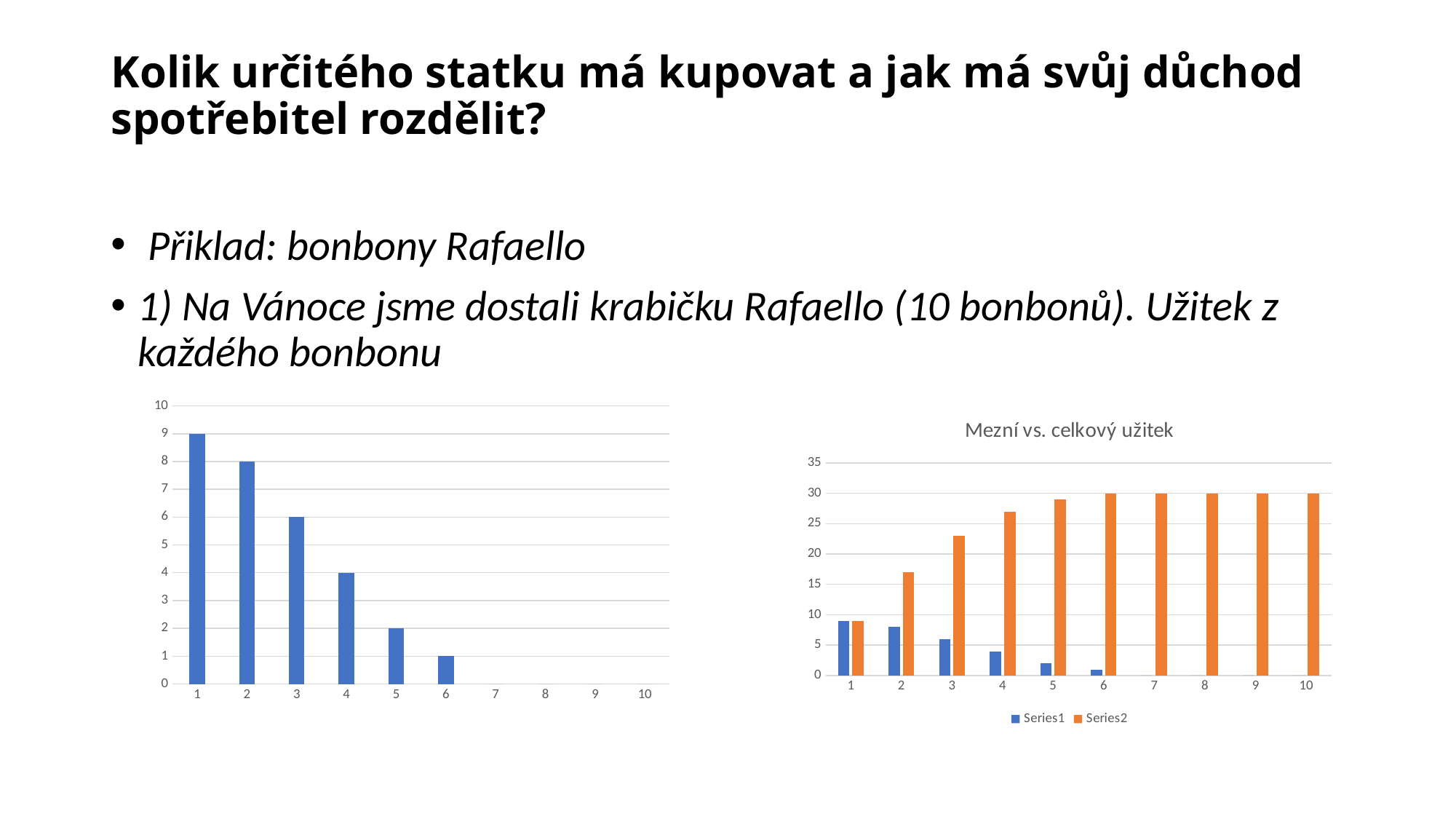
On the left chart, what is the value for category 3? 6 On the left chart, do the values rise or fall from category 1 to category 6? fall On the left chart, what is the value for category 6? 1 On the chart titled 'Mezní vs. celkový užitek', how many categories are shown on the x axis? 10 On the chart titled 'Mezní vs. celkový užitek', which series has the larger value at category 5, Series1 or Series2? Series2 On the chart titled 'Mezní vs. celkový užitek', how many series does the legend list? 2 On the left chart, what kind of chart is shown? bar chart On the chart titled 'Mezní vs. celkový užitek', is the Series2 value for category 4 greater or less than 25? greater On the chart titled 'Mezní vs. celkový užitek', is the Series2 value for category 2 greater or less than 15? greater On the left chart, what is the difference between the values for category 1 and category 4? 5 On the left chart, what is the value for category 1? 9 On the left chart, which category has the highest value? 1